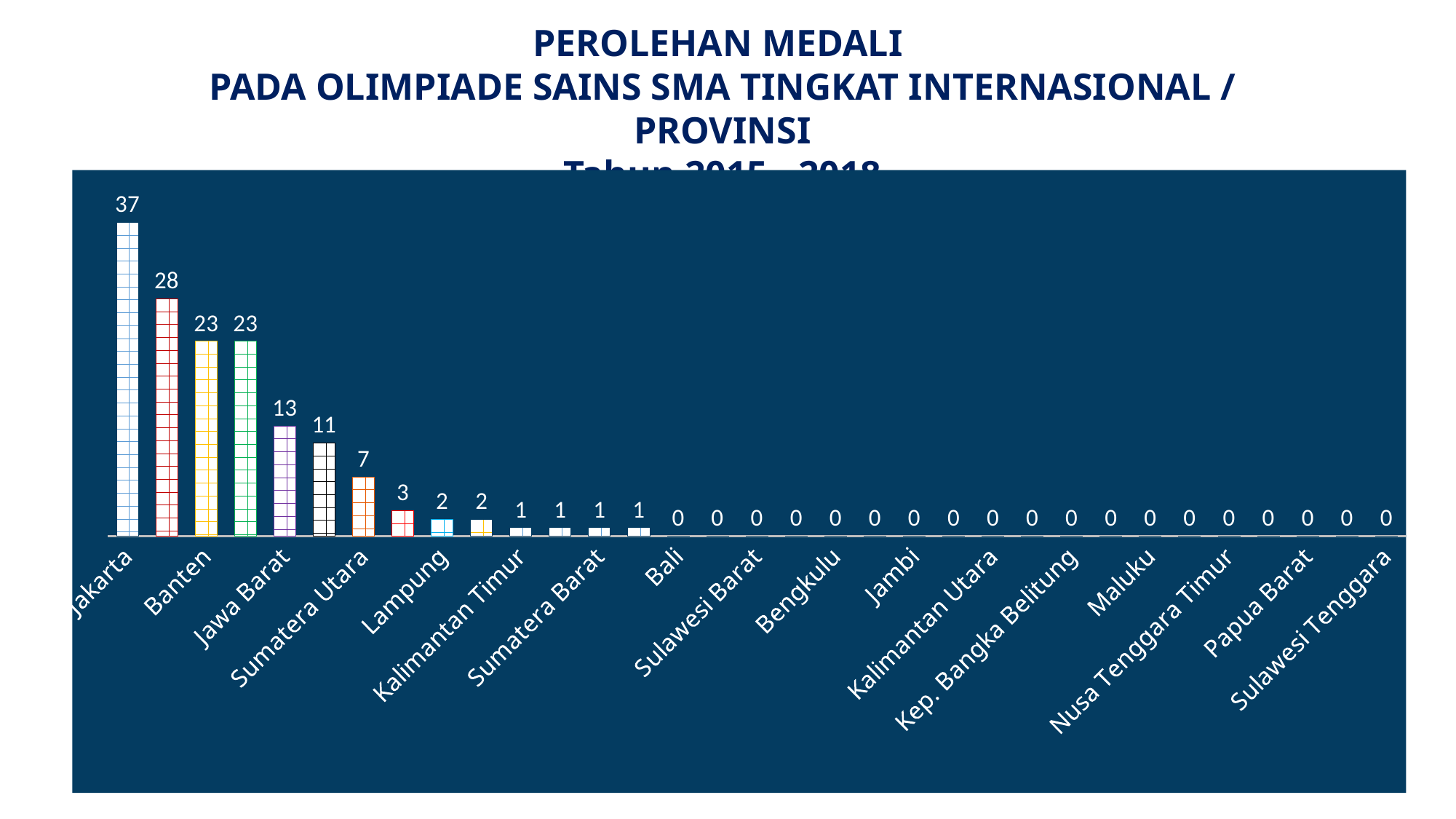
Which has more medals, Jakarta or Banten? Jakarta How many medals does Sulawesi Tenggara have? 0 How many bars show a value of 23? 2 What is the lowest value shown on the chart? 0 What kind of chart is shown on the slide? bar chart How many medals does Jakarta have? 37 What is the difference between the highest bar (37) and the second-highest bar (28)? 9 What is the second-highest value shown on the chart? 28 How many medals does Bali have? 0 Do the values rise or fall from left to right along the x axis? fall What is the background colour of the chart area? dark blue Which province has the highest number of medals? Jakarta